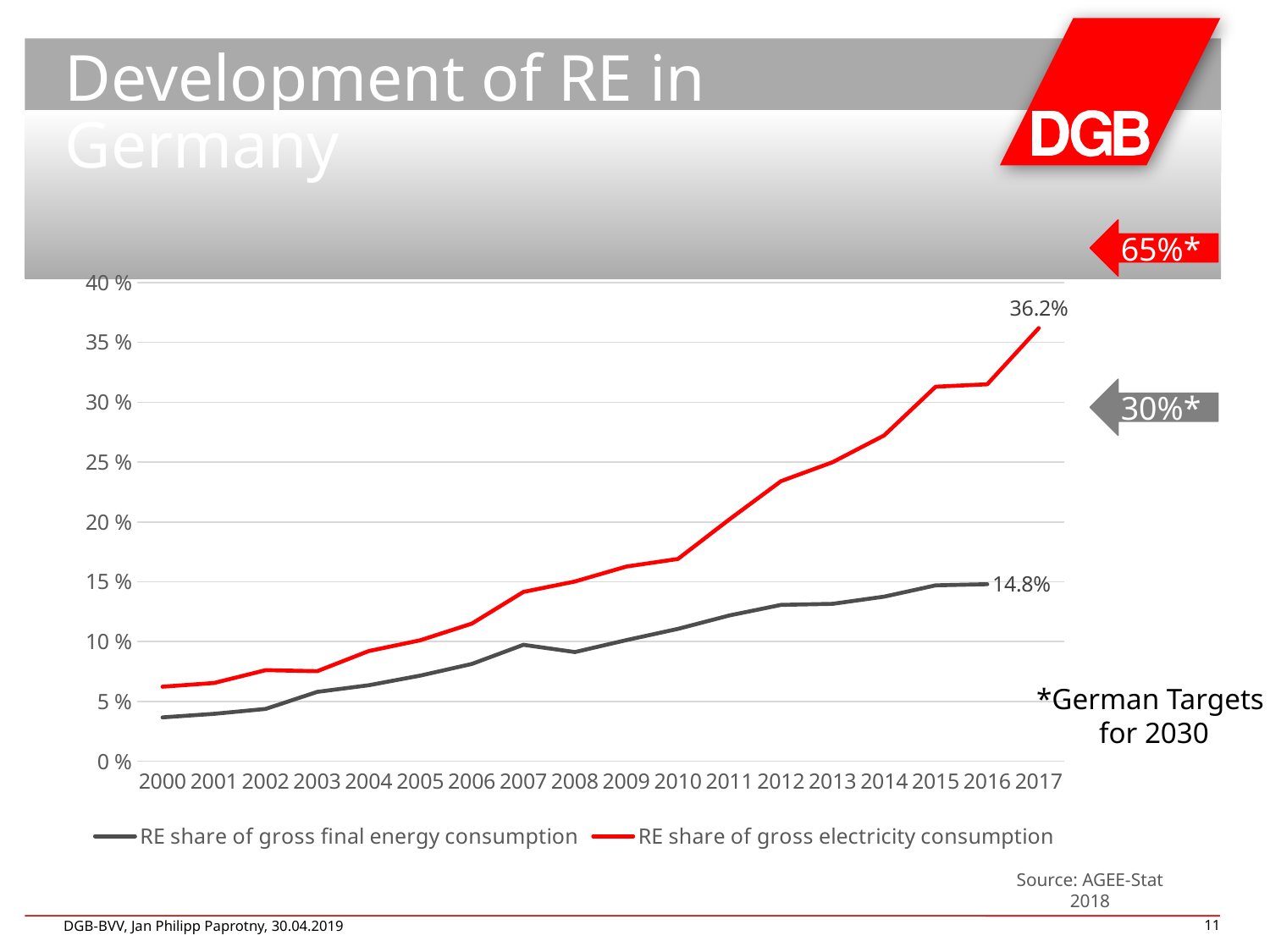
Do the values of the RE share of gross electricity consumption rise or fall from 2000 to 2017? rise What is the RE share of gross electricity consumption in 2017? 36.2% What type of chart is shown on the slide? line chart How many years are shown on the x axis? 18 How many series does the legend list? 2 In 2010, which series has the higher value: RE share of gross final energy consumption or RE share of gross electricity consumption? RE share of gross electricity consumption What is the difference between the two labelled end values, 36.2% and 14.8%? 21.4 percentage points Is the value for RE share of gross final energy consumption in 2000 greater or less than 5%? less In which year does the RE share of gross electricity consumption reach its highest value? 2017 What German target for 2030 is shown in the red arrow on the slide? 65% What value is labelled at the end of the RE share of gross final energy consumption line? 14.8% Is the value for RE share of gross electricity consumption in 2012 greater or less than 20%? greater